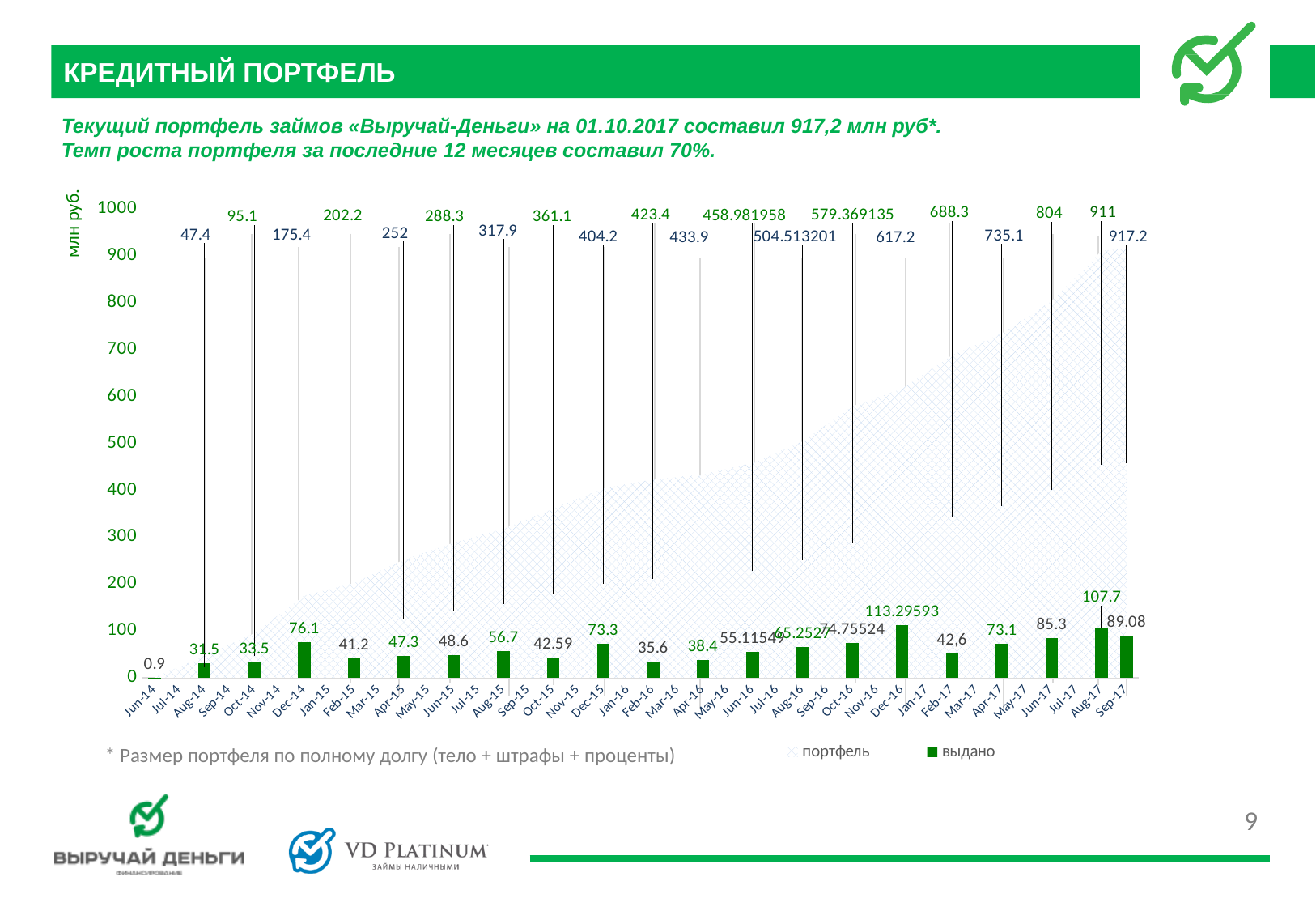
How many series does the legend list? 2 Does the портфель series rise or fall from Jun-14 to Sep-17? rise Which is larger, the выдано value for Aug-17 or for Sep-17? Aug-17 What is the value of the портфель series for Sep-17? 917.2 In which month is the выдано series lowest? Jun-14 What is the value of the выдано series for Dec-16? 113.29593 What is the difference between the портфель values for Sep-17 and Aug-17? 6.2 What is the value of the выдано series for Sep-17? 89.08 What is the value of the портфель series for Aug-17? 911 What unit is shown on the vertical axis label? млн руб. In which month is the выдано series highest? Dec-16 What colour are the bars for the выдано series? green